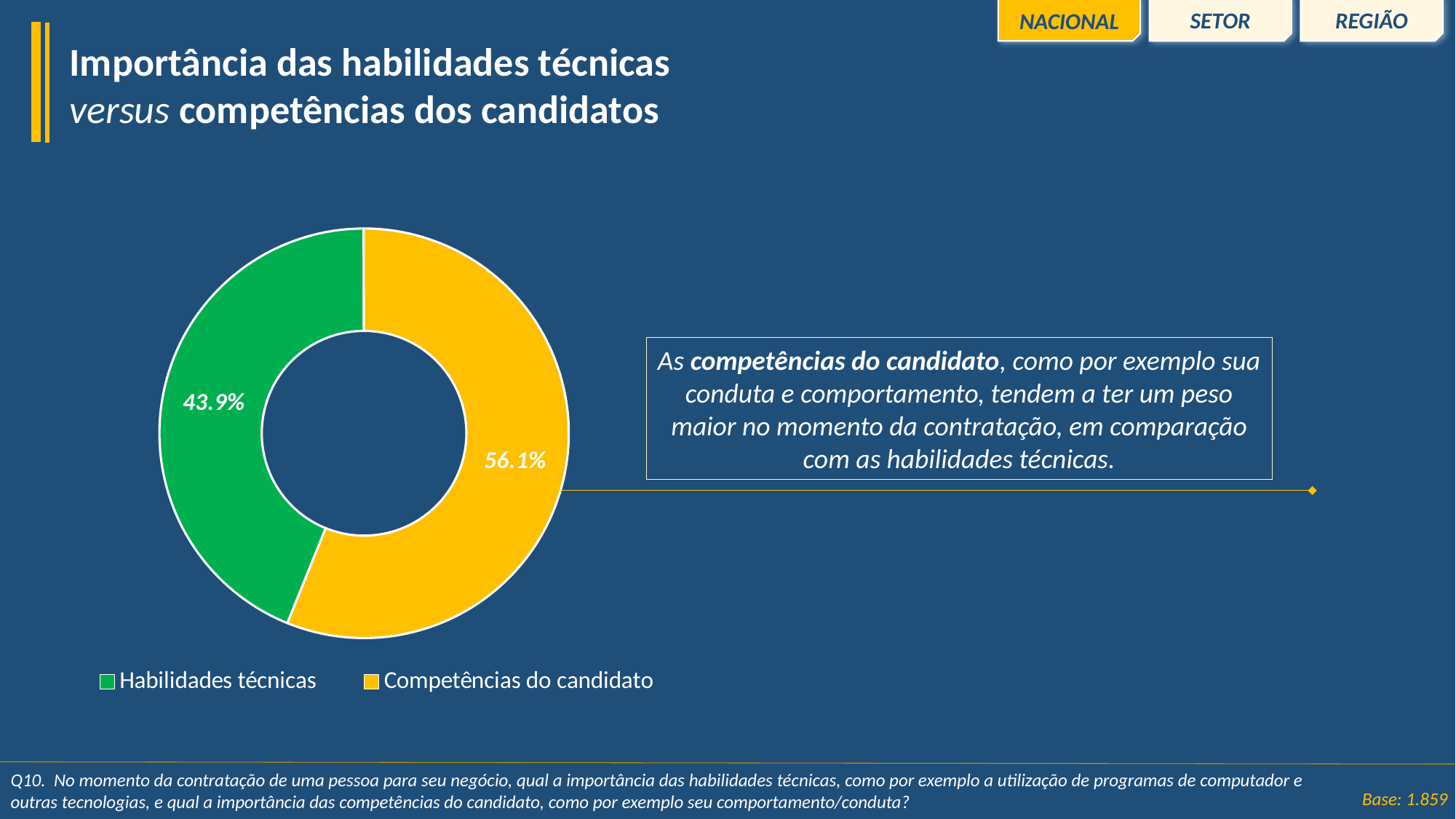
Which colour represents Competências do candidato in the chart? Yellow Which category has the larger share of the chart? Competências do candidato How many categories does the chart show? 2 What percentage is shown for Competências do candidato? 56.1% How many entries does the legend list? 2 What is the difference in percentage points between Competências do candidato and Habilidades técnicas? 12.2 What is the total of the two slices shown in the chart? 100% Which colour represents Habilidades técnicas in the chart? Green Which category has the smaller share of the chart? Habilidades técnicas Which is larger: the share for Habilidades técnicas or the share for Competências do candidato? Competências do candidato What percentage is shown for Habilidades técnicas? 43.9% What kind of chart is shown on the slide? Pie chart (doughnut)